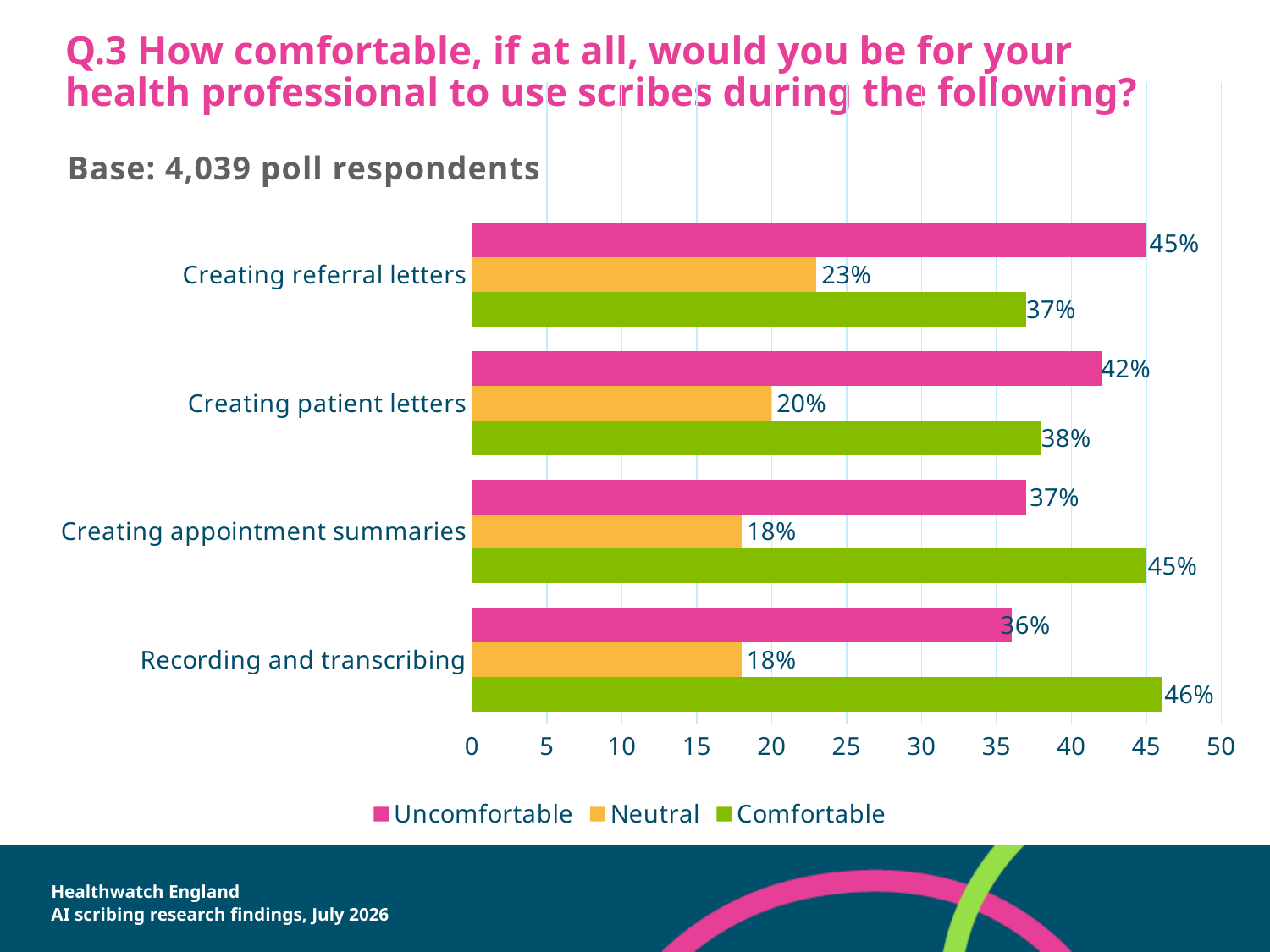
For creating appointment summaries, which is larger: the Uncomfortable or the Comfortable percentage? Comfortable How many series does the legend list? 3 What percentage of respondents were uncomfortable with scribes being used for creating referral letters? 45% Which colour represents the Neutral series in the chart? Orange What type of chart is shown on the slide? Bar chart Is the Neutral value for creating referral letters greater or less than 20? greater Which activity has the lowest Uncomfortable percentage? Recording and transcribing What is the difference between the Uncomfortable and Comfortable percentages for creating referral letters? 8% How many activities are shown on the chart? 4 Which activity has the highest Comfortable percentage? Recording and transcribing What is the Neutral value for creating patient letters? 20% What percentage were comfortable with scribes being used for recording and transcribing? 46%